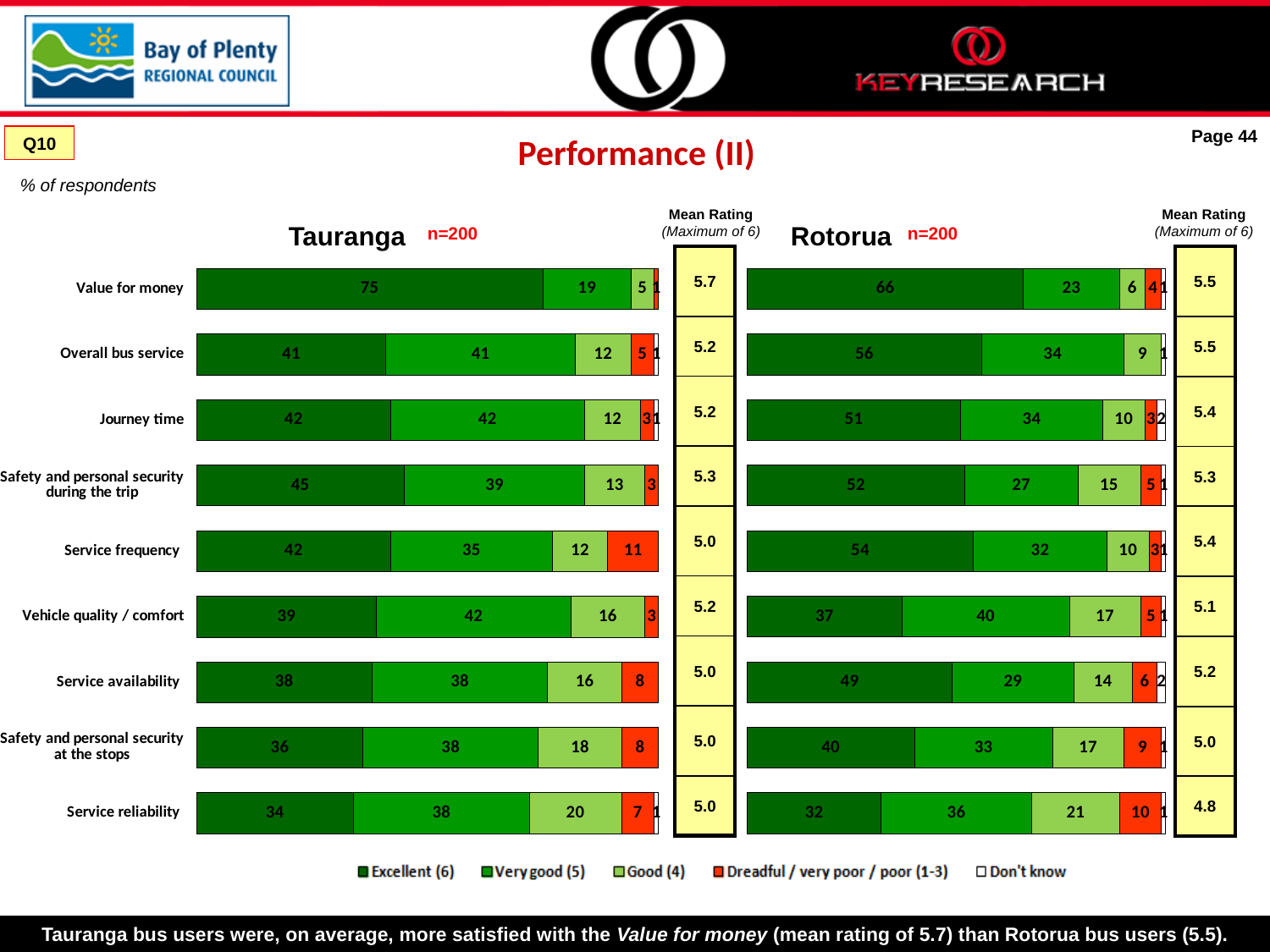
How many series does the legend list? 5 In the Rotorua chart, what percentage of respondents rated Service reliability as Good (4)? 21 In the Tauranga chart, which category has the highest Excellent (6) percentage? Value for money In the Tauranga chart, what is the difference between the Excellent (6) percentage for Value for money and for Service reliability? 41 Which has a larger Excellent (6) percentage for Overall bus service: Tauranga or Rotorua? Rotorua In the Tauranga chart, what percentage of respondents rated Value for money as Excellent (6)? 75 What is the mean rating for Service reliability in Rotorua? 4.8 What is the sample size (n) shown for the Tauranga chart? n=200 What kind of chart is used for the Tauranga data? Stacked bar chart In the Rotorua chart, which category has the lowest Excellent (6) percentage? Service reliability In the Rotorua chart, what is the Dreadful / very poor / poor (1-3) percentage for Safety and personal security at the stops? 9 How many categories are shown in the Tauranga chart? 9